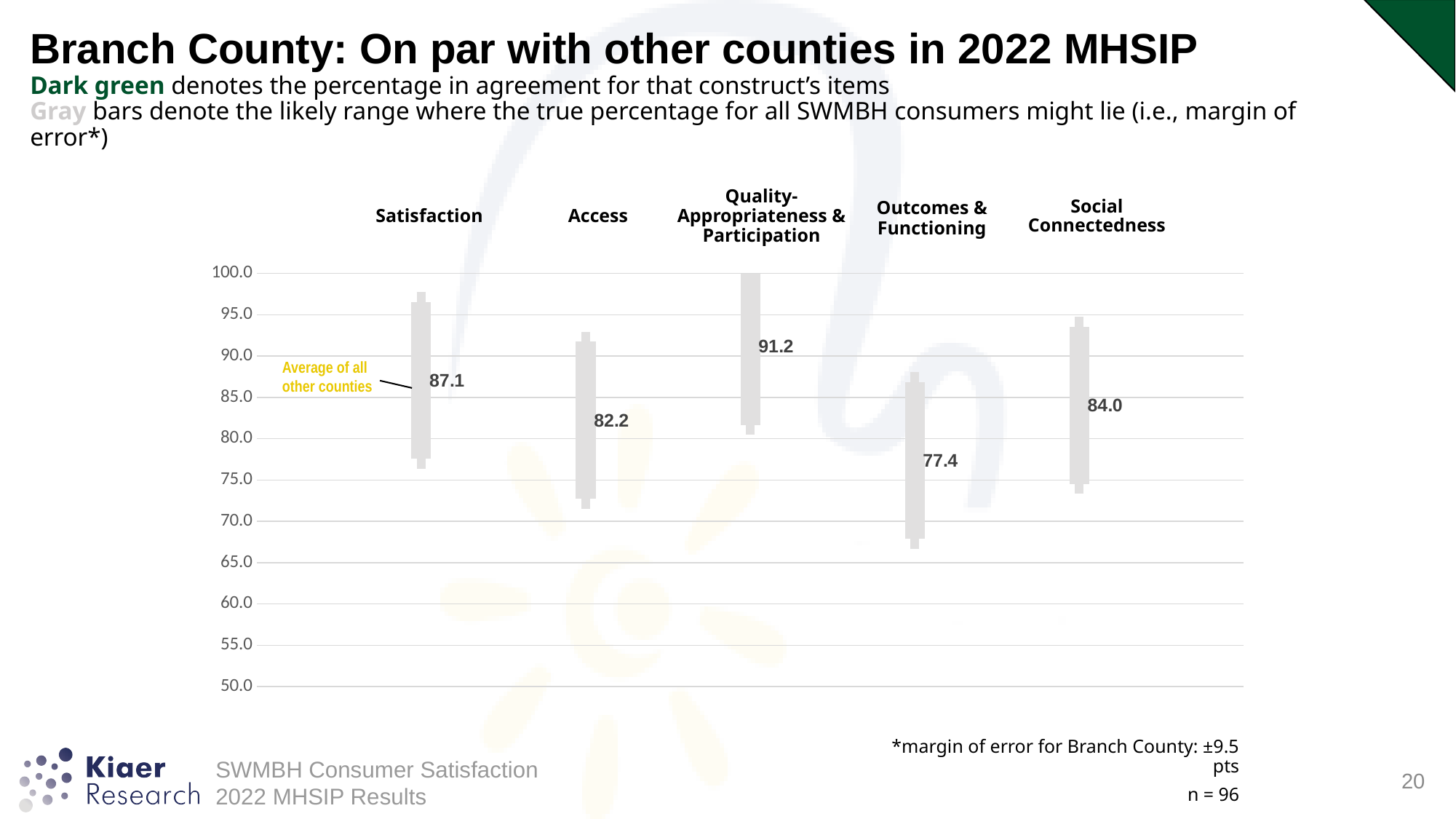
What is the difference between the labeled values for Quality-Appropriateness & Participation and Outcomes & Functioning? 13.8 What value is labeled for Quality-Appropriateness & Participation? 91.2 What value is labeled for Social Connectedness? 84.0 What value is labeled for Outcomes & Functioning? 77.4 Which has the larger labeled value, Satisfaction or Social Connectedness? Satisfaction According to the footnote, what is the margin of error for Branch County? ±9.5 pts What value is labeled for Satisfaction on the chart? 87.1 Which construct has the highest labeled value? Quality-Appropriateness & Participation How many constructs are shown on the chart? 5 What kind of chart is shown on the slide? Bar chart Which construct has the lowest labeled value? Outcomes & Functioning What value is labeled for Access on the chart? 82.2